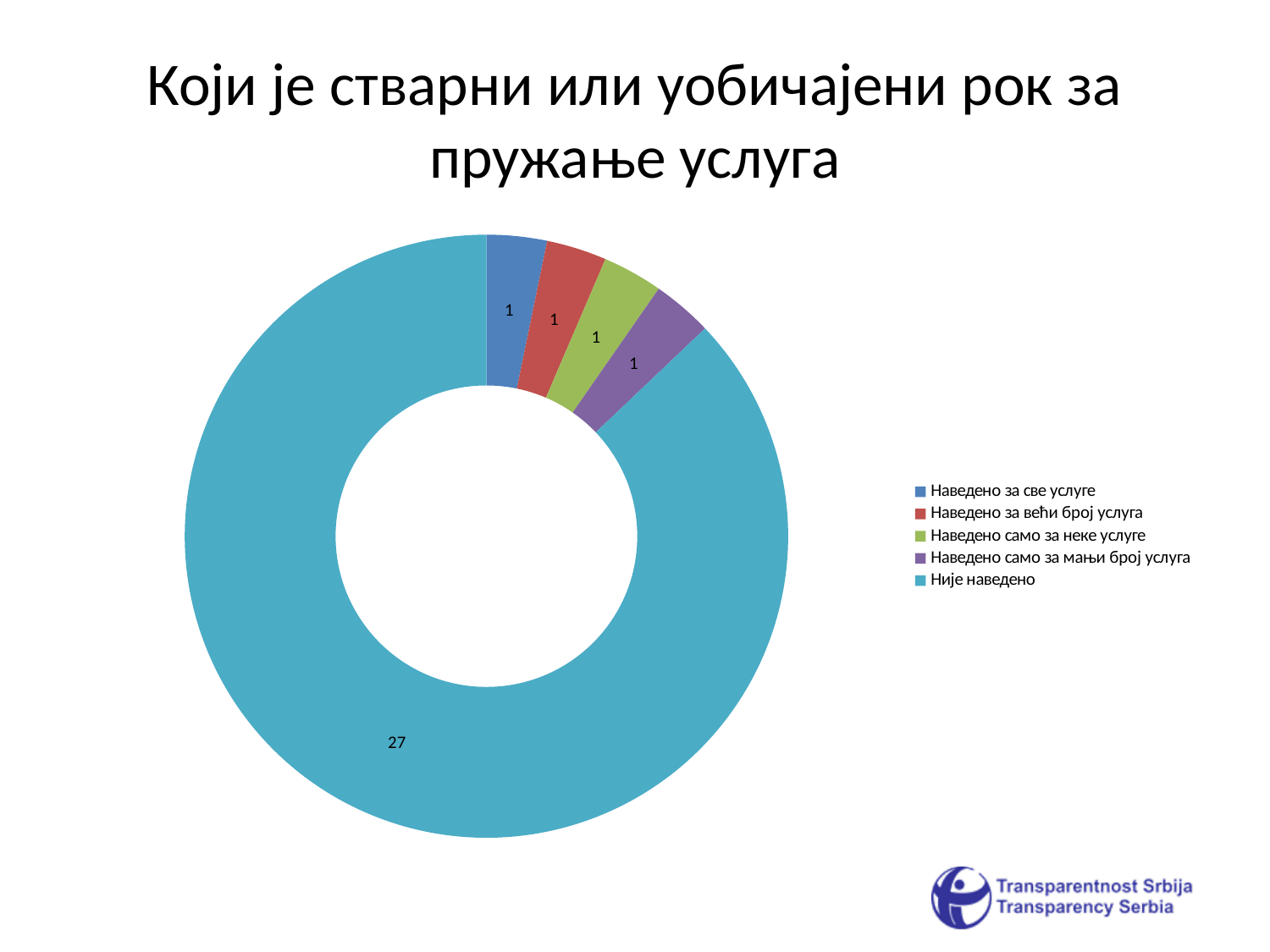
What is the difference between the value for "Није наведено" and the value for "Наведено за већи број услуга"? 26 Which category has the highest value? Није наведено What is the total of all the values shown in the chart? 31 What kind of chart is shown on the slide? Doughnut chart Which is larger, the value for "Није наведено" or the value for "Наведено само за мањи број услуга"? Није наведено What is the value for "Није наведено"? 27 How many categories does the chart show? 5 How many entries does the legend list? 5 What is the value for "Наведено само за неке услуге"? 1 What is the value for "Наведено за све услуге"? 1 Which colour represents "Наведено за све услуге" in the legend? Blue What is the title of the slide? Који је стварни или уобичајени рок за пружање услуга